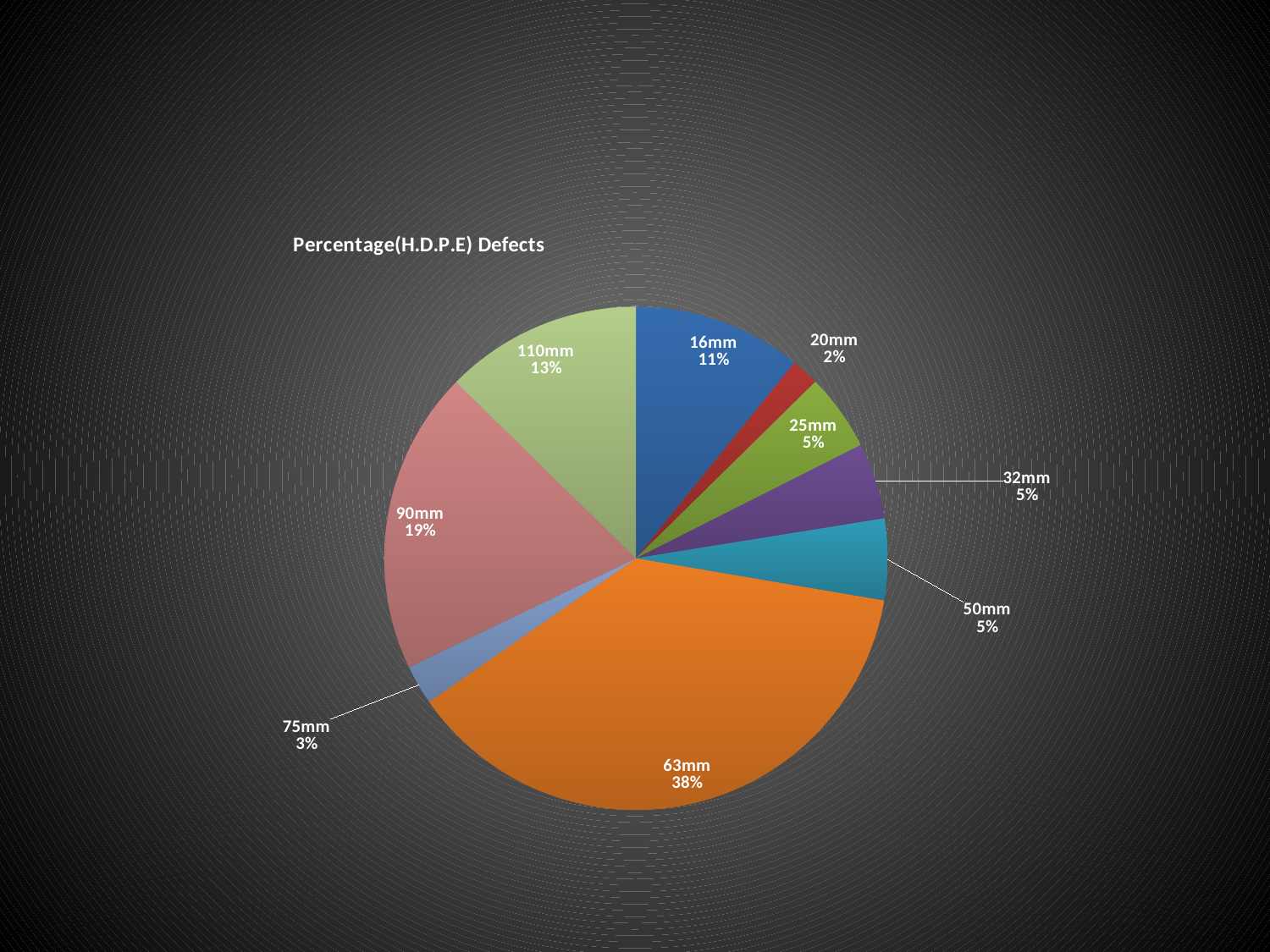
What percentage of defects is attributed to 63mm? 38% What percentage of defects is attributed to 110mm? 13% What type of chart is shown on the slide? pie chart What is the title of the chart? Percentage(H.D.P.E) Defects What is the difference in percentage points between the 63mm and 90mm shares? 19 What percentage of defects is attributed to 75mm? 3% What percentage of defects is attributed to 90mm? 19% Which pipe size has the smallest share of defects? 20mm Which pipe size has the largest share of defects? 63mm Which has a larger share of defects, 110mm or 16mm? 110mm What percentage of defects is attributed to 16mm? 11% How many pipe size categories are shown in the pie chart? 9